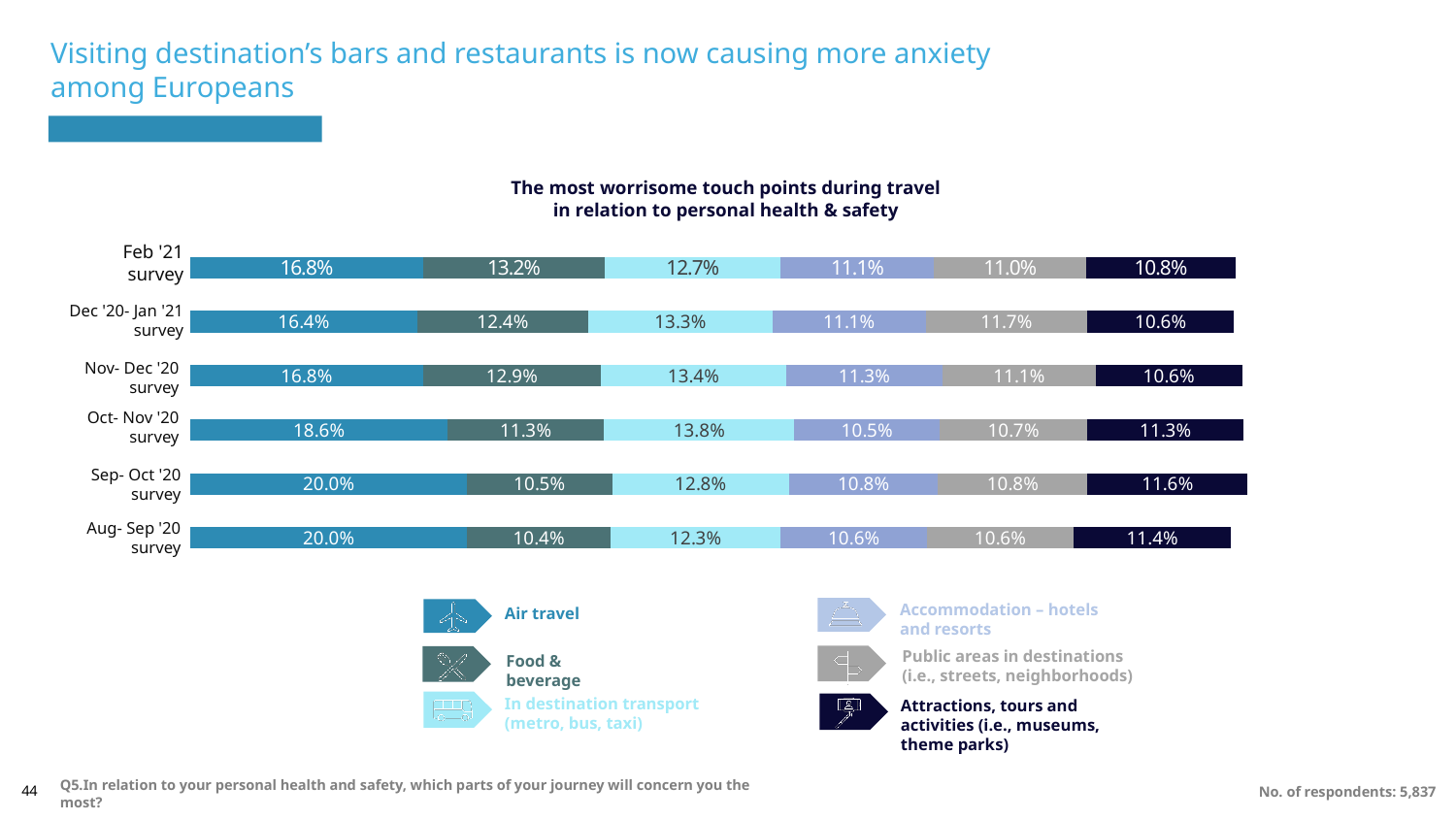
How many survey periods are shown on the chart? 6 What is the total of the stacked bar for the Feb '21 survey? 75.6% What is the value for In destination transport in the Oct-Nov '20 survey? 13.8% What is the value for Food & beverage in the Dec '20-Jan '21 survey? 12.4% What is the value for Attractions, tours and activities in the Sep-Oct '20 survey? 11.6% What type of chart is shown on the slide? Stacked bar chart In the Feb '21 survey, which is larger: the value for Food & beverage or the value for In destination transport? Food & beverage How many series does the legend list? 6 What is the difference between the Air travel value in the Aug-Sep '20 survey and in the Feb '21 survey? 3.2% In which survey period is the Food & beverage value lowest? Aug-Sep '20 survey What is the value for Air travel in the Feb '21 survey? 16.8% In which survey period is the Food & beverage value highest? Feb '21 survey